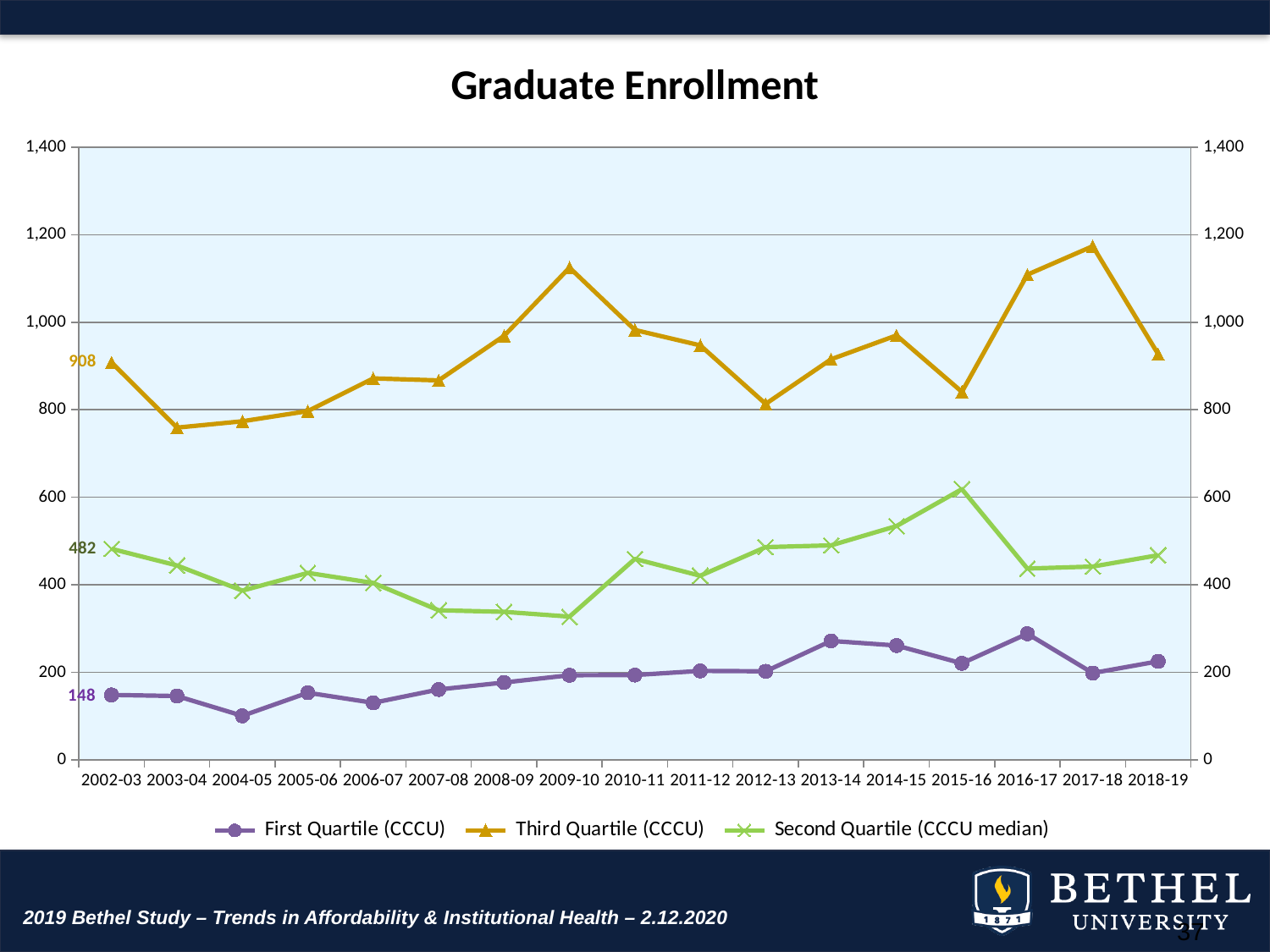
In 2002-03, what is the difference between the Third Quartile (CCCU) and First Quartile (CCCU) values? 760 In which year does the Second Quartile (CCCU median) series reach its highest value? 2015-16 What is the value of the Third Quartile (CCCU) series in 2002-03? 908 In 2002-03, what is the difference between the Second Quartile (CCCU median) and First Quartile (CCCU) values? 334 How many academic years are shown on the x axis? 17 In which year does the Third Quartile (CCCU) series reach its highest value? 2017-18 What is the value of the First Quartile (CCCU) series in 2002-03? 148 In which year does the First Quartile (CCCU) series reach its lowest value? 2004-05 How many series does the legend list? 3 Is the value for Second Quartile (CCCU median) in 2015-16 greater or less than 600? greater Is the value for Third Quartile (CCCU) in 2009-10 greater or less than 1,000? greater What is the value of the Second Quartile (CCCU median) series in 2002-03? 482